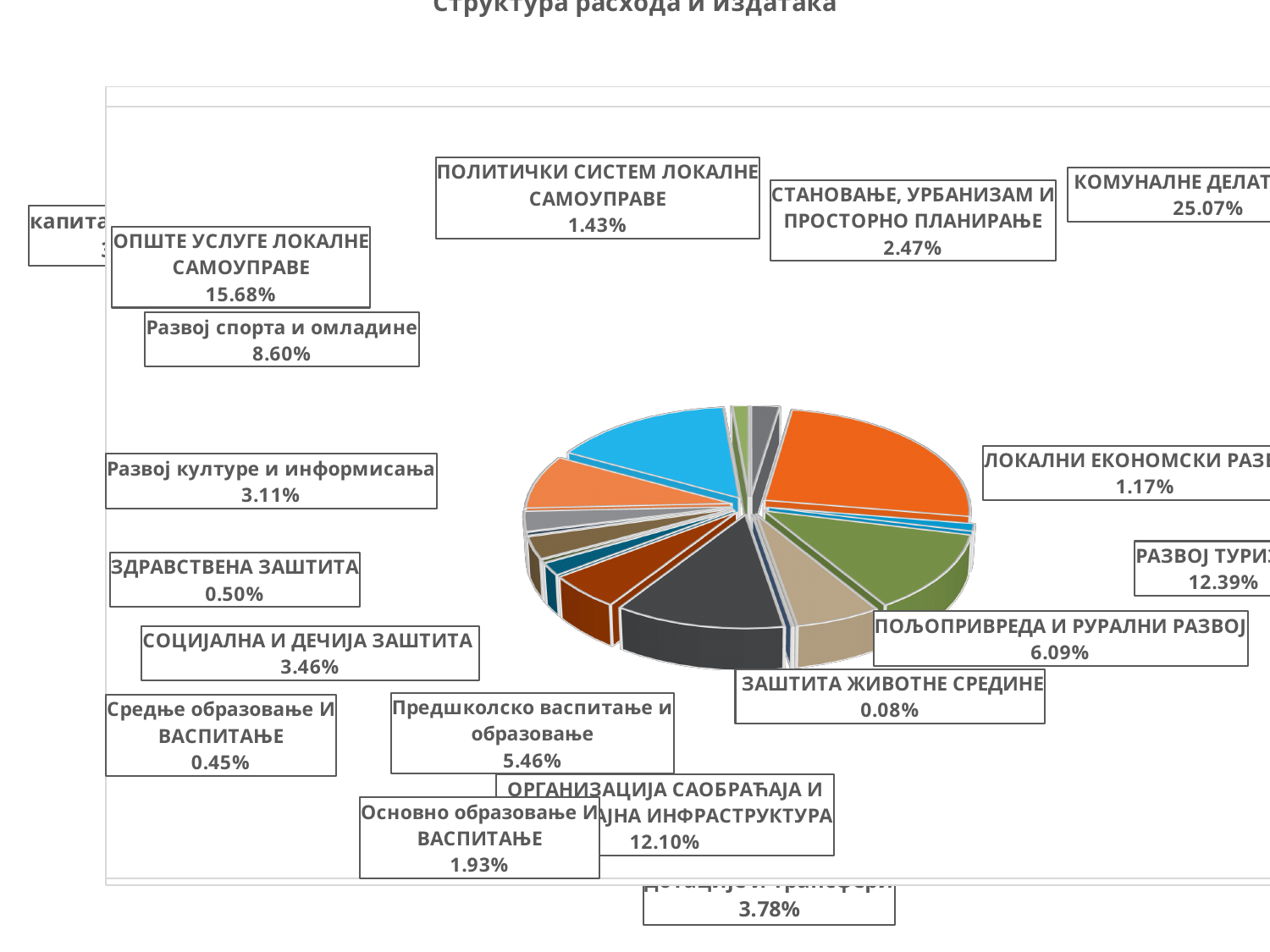
What share is shown for Предшколско васпитање и образовање? 5.46% What kind of chart is shown on the slide? Pie chart What is the value for СТАНОВАЊЕ, УРБАНИЗАМ И ПРОСТОРНО ПЛАНИРАЊЕ? 2.47% Which is larger: СОЦИЈАЛНА И ДЕЧИЈА ЗАШТИТА or Развој културе и информисања? СОЦИЈАЛНА И ДЕЧИЈА ЗАШТИТА Which category has the smallest share in the pie chart? ЗАШТИТА ЖИВОТНЕ СРЕДИНЕ What is the difference between Предшколско васпитање и образовање and Основно образовање И ВАСПИТАЊЕ? 3.53% What is the value shown for Развој спорта и омладине? 8.60% Which is larger: Предшколско васпитање и образовање or Основно образовање И ВАСПИТАЊЕ? Предшколско васпитање и образовање What is the difference between the shares of ОПШТЕ УСЛУГЕ ЛОКАЛНЕ САМОУПРАВЕ and Развој спорта и омладине? 7.08% What share does ОПШТЕ УСЛУГЕ ЛОКАЛНЕ САМОУПРАВЕ have in the pie chart? 15.68% What percentage is shown for ПОЉОПРИВРЕДА И РУРАЛНИ РАЗВОЈ? 6.09% What is the value for ЗДРАВСТВЕНА ЗАШТИТА? 0.50%